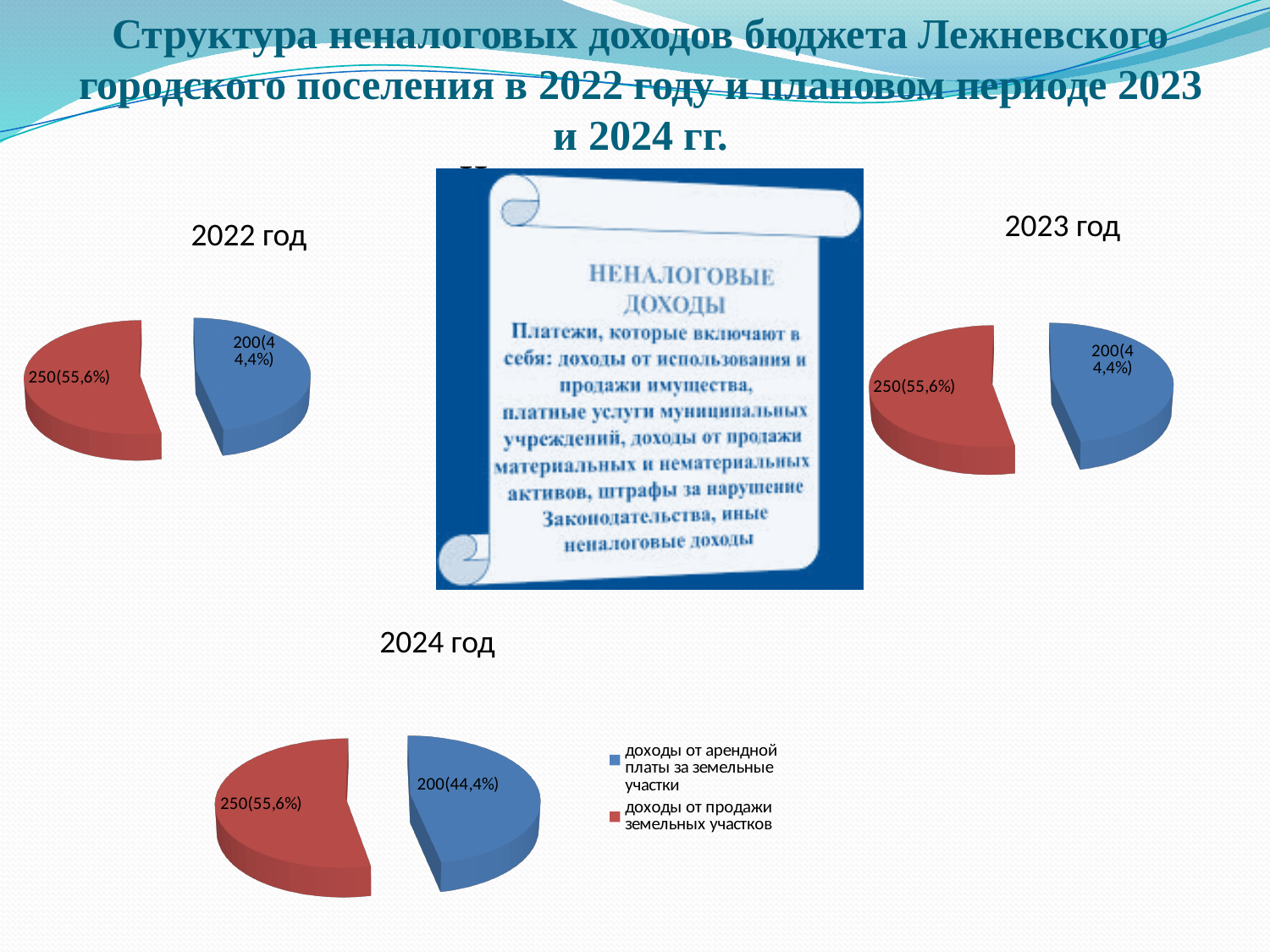
In the "2024 год" chart, what value is shown for доходы от продажи земельных участков? 250(55,6%) In the "2024 год" chart, what share of the pie is доходы от продажи земельных участков? 55,6% In the "2024 год" chart, what is the difference between the value for доходы от продажи земельных участков and the value for доходы от арендной платы за земельные участки? 50 How many entries does the legend at the bottom of the slide list? 2 In the "2024 год" chart, which category has the smallest slice? доходы от арендной платы за земельные участки In the "2024 год" chart, which category has the largest slice? доходы от продажи земельных участков In the "2024 год" chart, what value is shown for доходы от арендной платы за земельные участки? 200(44,4%) In the "2024 год" chart, which is larger: доходы от продажи земельных участков or доходы от арендной платы за земельные участки? доходы от продажи земельных участков What kind of chart is the "2022 год" chart? pie chart In the "2024 год" chart, what share of the pie is доходы от арендной платы за земельные участки? 44,4% How many slices does the "2023 год" pie chart have? 2 What colour is the slice for доходы от продажи земельных участков in the "2024 год" chart? red